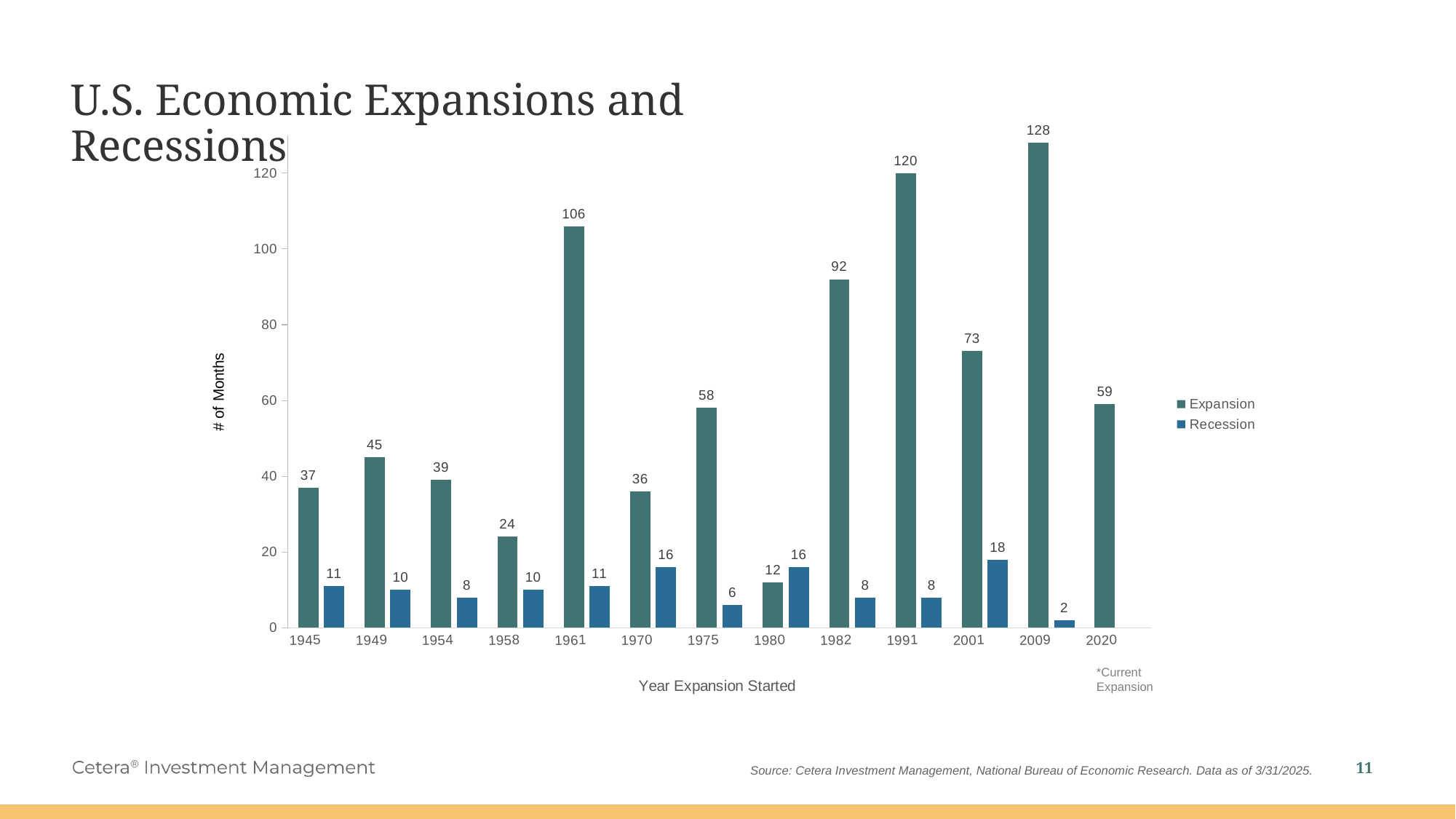
Is the Expansion value for 2001 greater or less than 60? greater How many series does the legend list? 2 How many years are shown on the x axis? 13 What is the label of the y axis? # of Months What kind of chart is shown on the slide? bar chart What is the Expansion value for 1961? 106 Which year has the lowest Recession value? 2009 What is the Recession value for 1980? 16 What is the difference between the Expansion values for 1991 and 1982? 28 Which is larger, the Expansion value for 1975 or for 2020? 2020 What is the Recession value for 2001? 18 Which year has the highest Expansion value? 2009